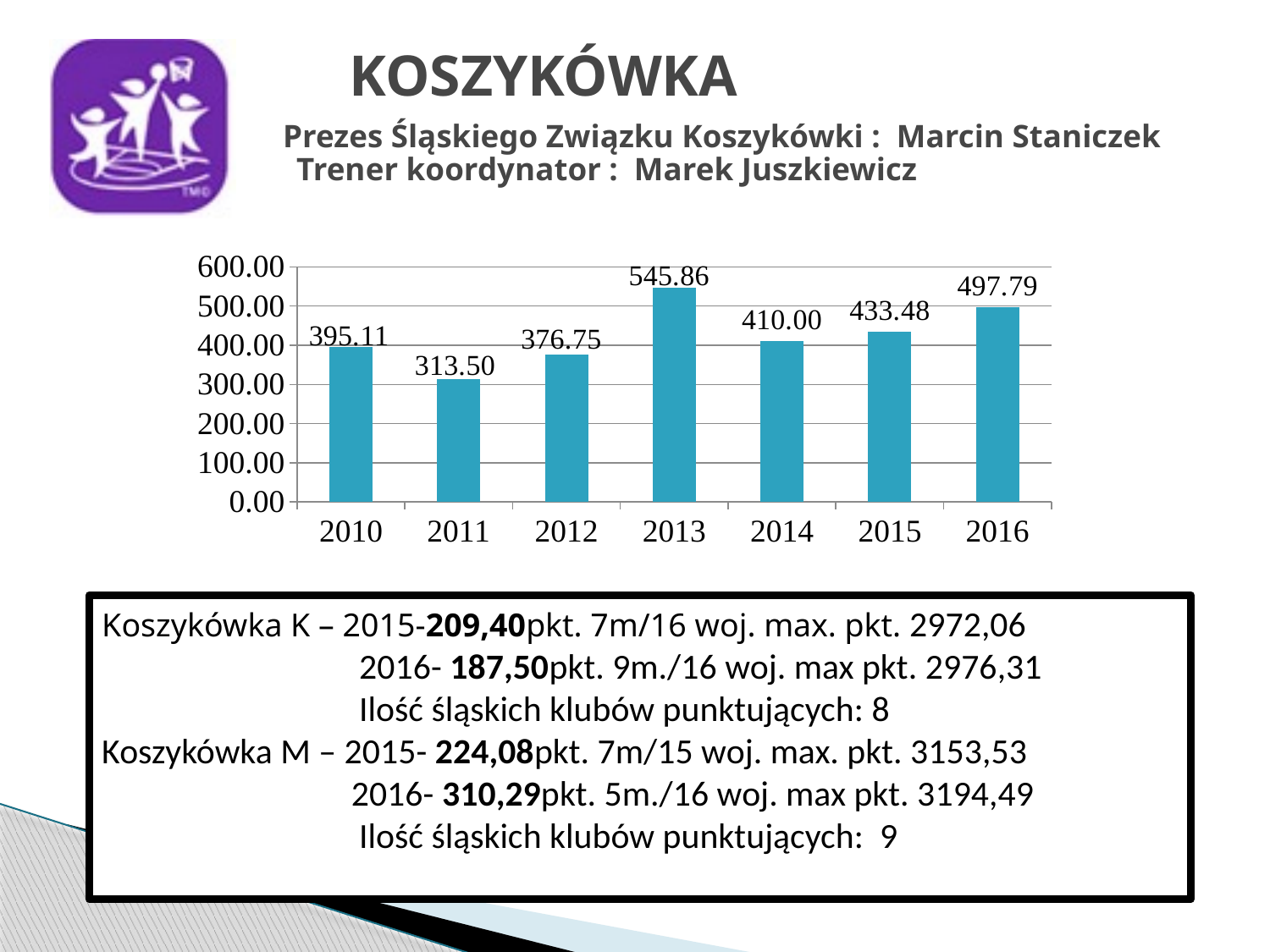
What kind of chart is shown on the slide? bar chart Which year has the lowest value? 2011 How many years are shown on the x axis? 7 Which year has the highest value? 2013 Is the value for 2015 greater or less than 400.00? greater What is the difference between the values for 2016 and 2015? 64.31 What is the value shown for 2013? 545.86 What is the value shown for 2016? 497.79 Which is larger, the value for 2010 or the value for 2012? 2010 Do the values rise or fall from 2014 to 2016? rise What is the value shown for 2011? 313.50 What is the difference between the values for 2013 and 2011? 232.36